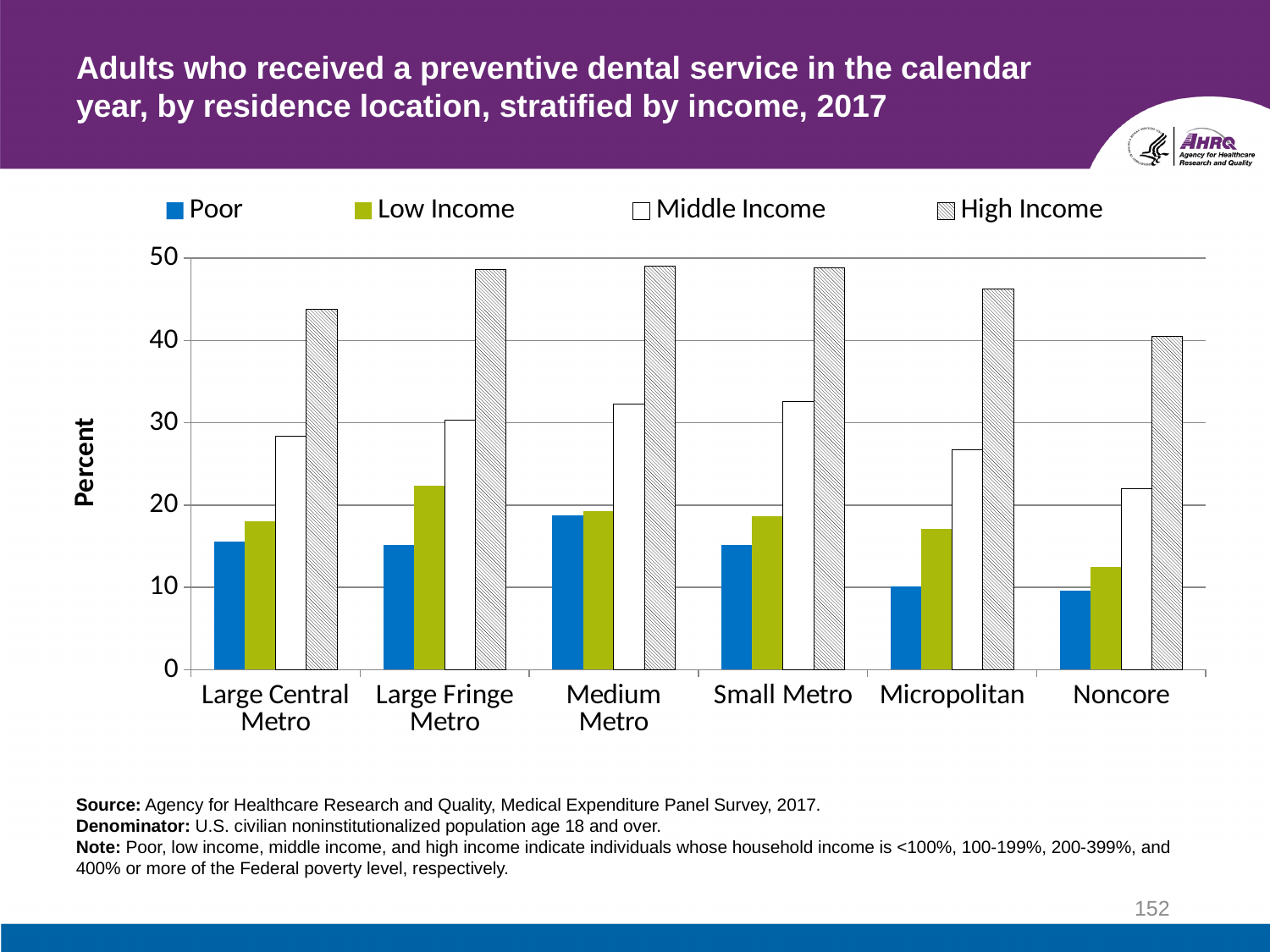
Is the Middle Income value for Large Central Metro greater or less than 30? less What kind of chart is shown on the slide? bar chart What is the label on the vertical axis? Percent Which is larger for Small Metro: the Middle Income value or the Low Income value? Middle Income How many residence location categories are shown on the x axis? 6 Which residence location has the lowest High Income value? Noncore How many income groups does the legend list? 4 Is the High Income value for Large Central Metro greater or less than 40? greater Which residence location has the highest Low Income value? Large Fringe Metro Is the Low Income value for Large Fringe Metro greater or less than 20? greater Which residence location has the highest Poor value? Medium Metro Which residence location has the lowest Middle Income value? Noncore